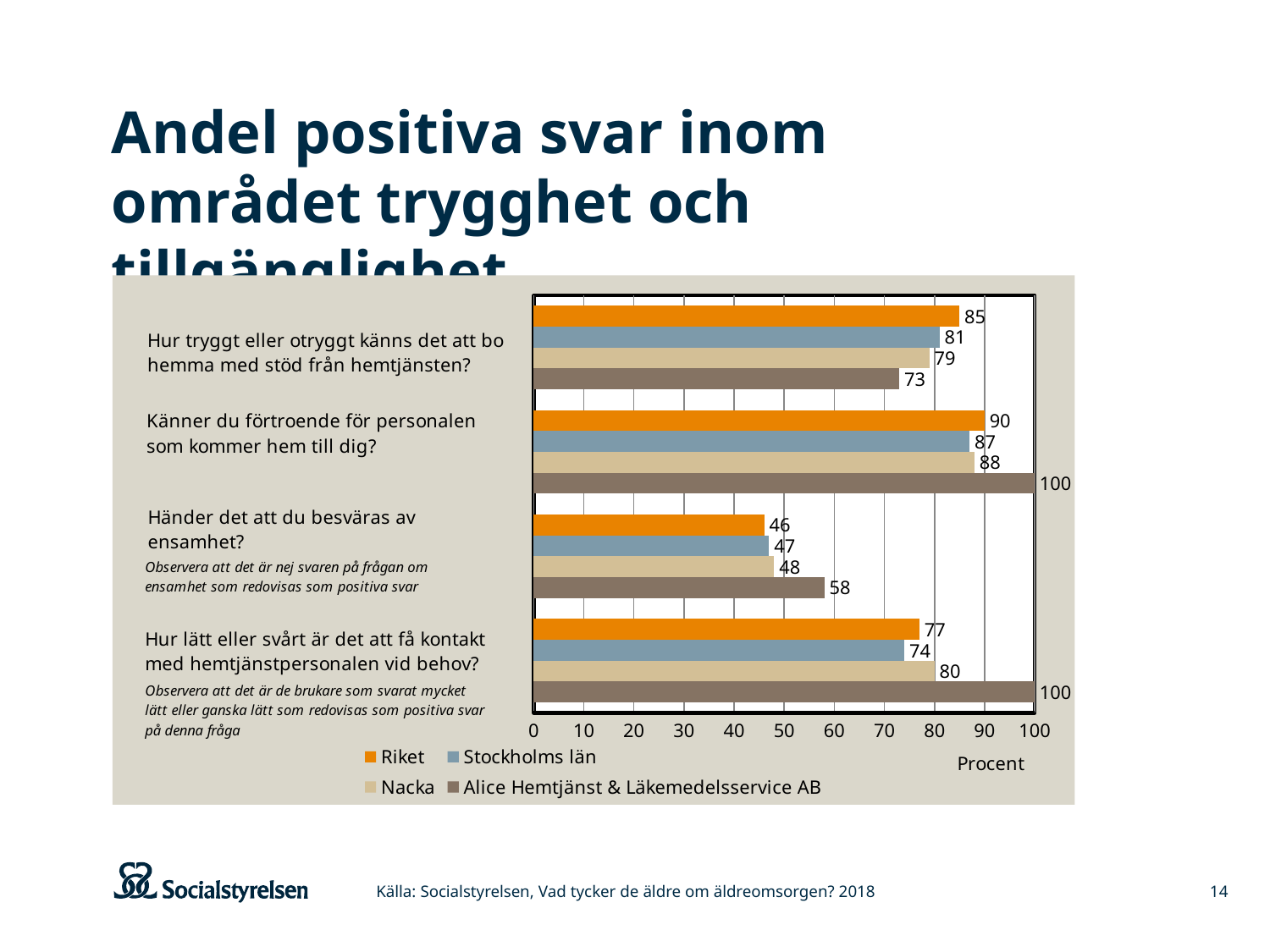
How many series does the legend list? 4 Which series has the highest value on the question "Händer det att du besväras av ensamhet?"? Alice Hemtjänst & Läkemedelsservice AB What is the value for Nacka on the question "Händer det att du besväras av ensamhet?"? 48 What is the value for Alice Hemtjänst & Läkemedelsservice AB on the question "Känner du förtroende för personalen som kommer hem till dig?"? 100 Which series has the lowest value on the question "Hur tryggt eller otryggt känns det att bo hemma med stöd från hemtjänsten?"? Alice Hemtjänst & Läkemedelsservice AB What is the label on the horizontal axis of the chart? Procent What is the value for Riket on the question "Hur tryggt eller otryggt känns det att bo hemma med stöd från hemtjänsten?"? 85 What is the value for Stockholms län on the question "Hur lätt eller svårt är det att få kontakt med hemtjänstpersonalen vid behov?"? 74 Is the value for Riket on the question "Händer det att du besväras av ensamhet?" greater or less than 50? less What is the difference between the Alice Hemtjänst & Läkemedelsservice AB value and the Riket value on the question "Hur lätt eller svårt är det att få kontakt med hemtjänstpersonalen vid behov?"? 23 Which is larger on the question "Hur tryggt eller otryggt känns det att bo hemma med stöd från hemtjänsten?": the value for Riket or the value for Nacka? Riket What kind of chart is shown on the slide? Bar chart